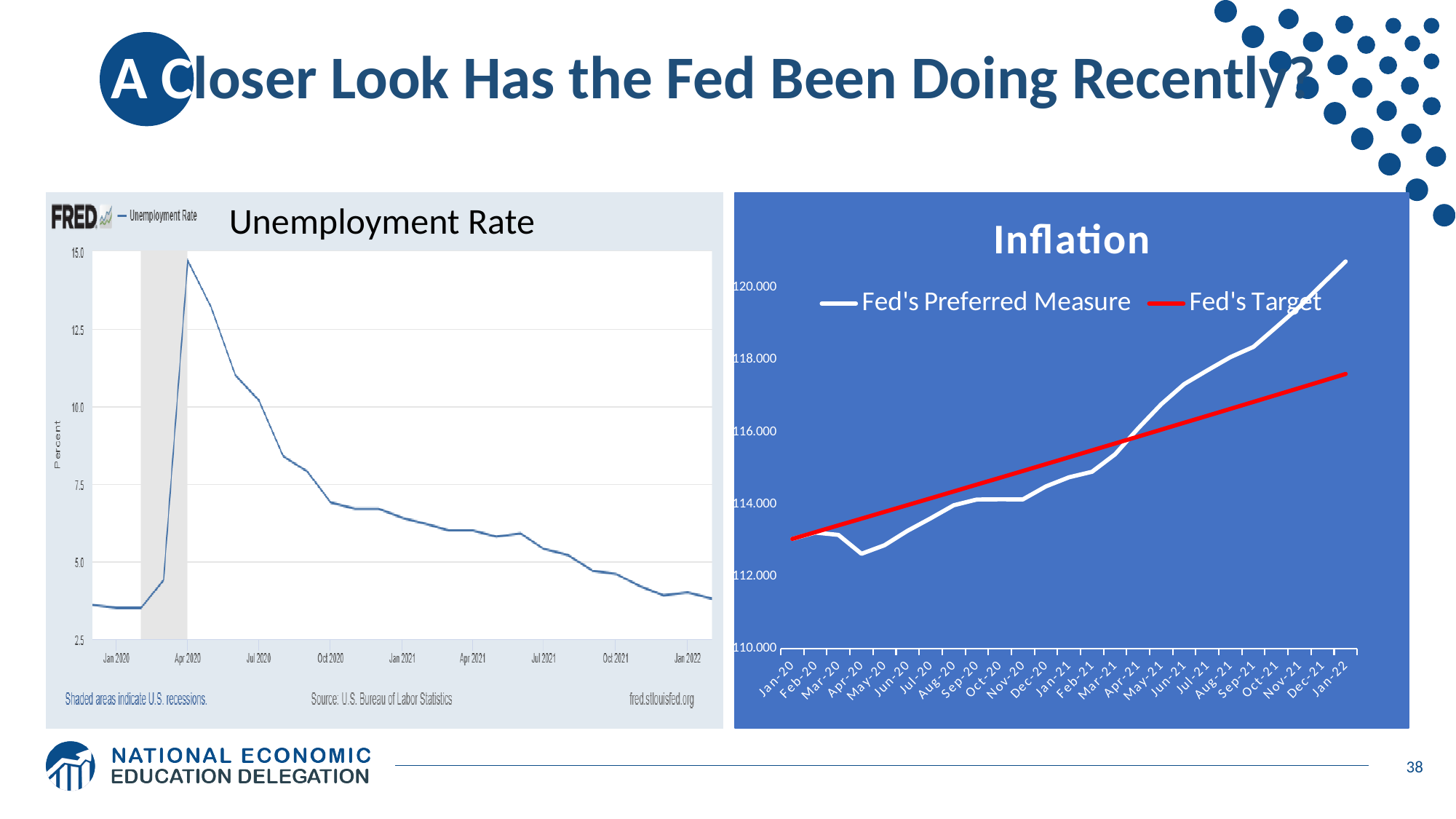
What kind of chart is the Inflation chart? line chart In the Unemployment Rate chart, does the unemployment rate rise or fall from July 2020 to January 2022? fall In the Inflation chart, what colour is the line for Fed's Target? red In the Inflation chart, which series is higher at Apr-20, Fed's Preferred Measure or Fed's Target? Fed's Target In the Inflation chart, is the value of Fed's Preferred Measure at Jan-22 greater or less than 118.000? greater In the Inflation chart, which series is higher at Jan-22, Fed's Preferred Measure or Fed's Target? Fed's Preferred Measure What kind of chart is the Unemployment Rate chart? line chart In the Inflation chart, does the Fed's Target line rise or fall from Jan-20 to Jan-22? rise In the Inflation chart, how many months are labelled on the x axis from Jan-20 to Jan-22? 25 In the Unemployment Rate chart, is the peak value in April 2020 greater or less than 12.5? greater How many series does the legend of the Inflation chart list? 2 In the Inflation chart, is the value of Fed's Target at Jan-20 greater or less than 114.000? less